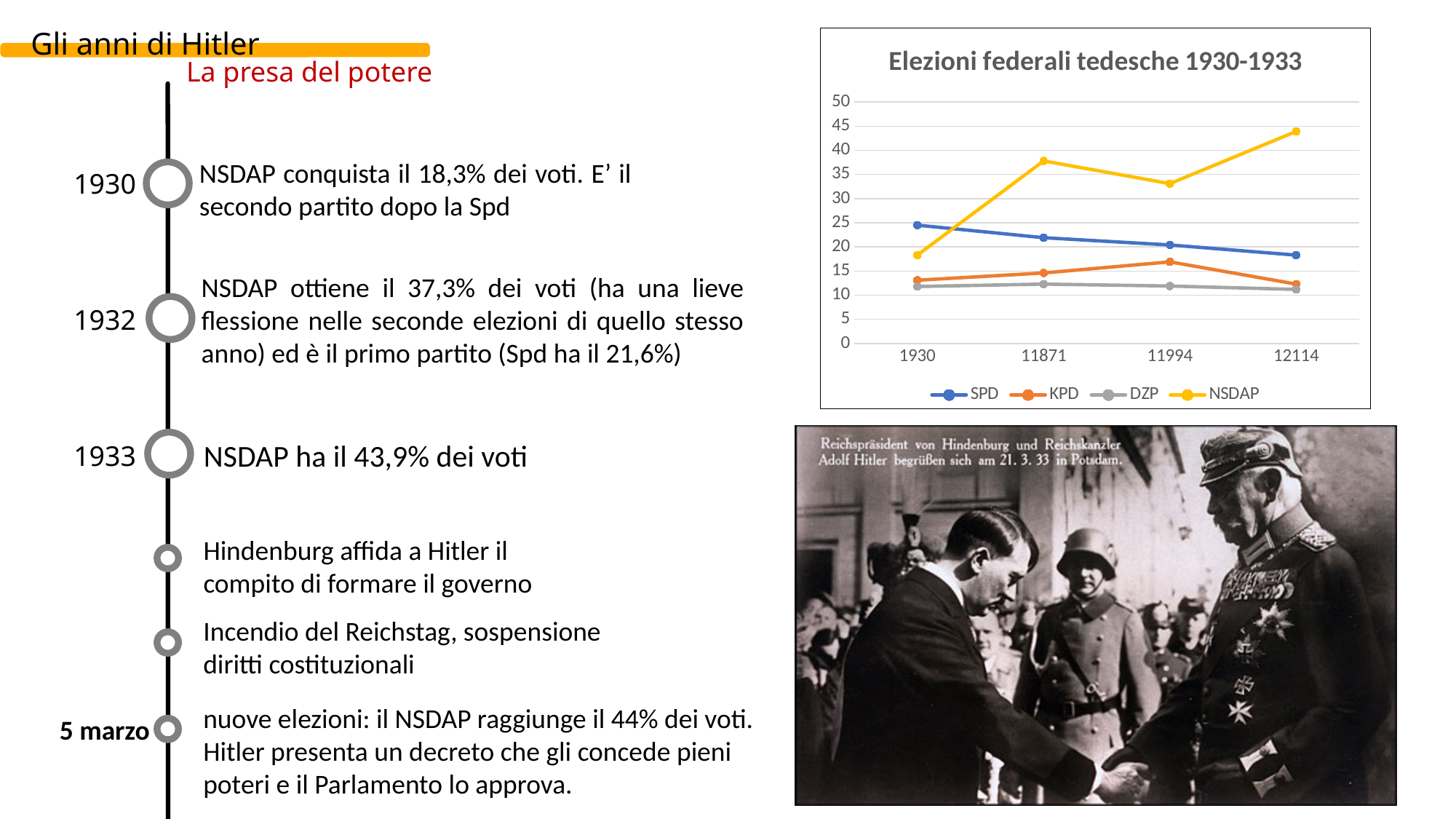
How many series does the legend of the chart 'Elezioni federali tedesche 1930-1933' list? 4 In the chart 'Elezioni federali tedesche 1930-1933', is the value for DZP at 12114 greater or less than 15? less In the chart 'Elezioni federali tedesche 1930-1933', do the values for SPD rise or fall along the x axis? fall What colour is the NSDAP line in the chart 'Elezioni federali tedesche 1930-1933'? yellow In the chart 'Elezioni federali tedesche 1930-1933', which series has the highest value at the last x-axis point (12114)? NSDAP In the chart 'Elezioni federali tedesche 1930-1933', which series has the highest value at 1930? SPD How many points are plotted along the x axis for each series in the chart 'Elezioni federali tedesche 1930-1933'? 4 In the chart 'Elezioni federali tedesche 1930-1933', is the value for NSDAP at 11871 greater or less than 30? greater In the chart 'Elezioni federali tedesche 1930-1933', is the value for NSDAP at 12114 greater or less than 40? greater In the chart 'Elezioni federali tedesche 1930-1933', which is larger at 11871: SPD or NSDAP? NSDAP What kind of chart is 'Elezioni federali tedesche 1930-1933'? line chart